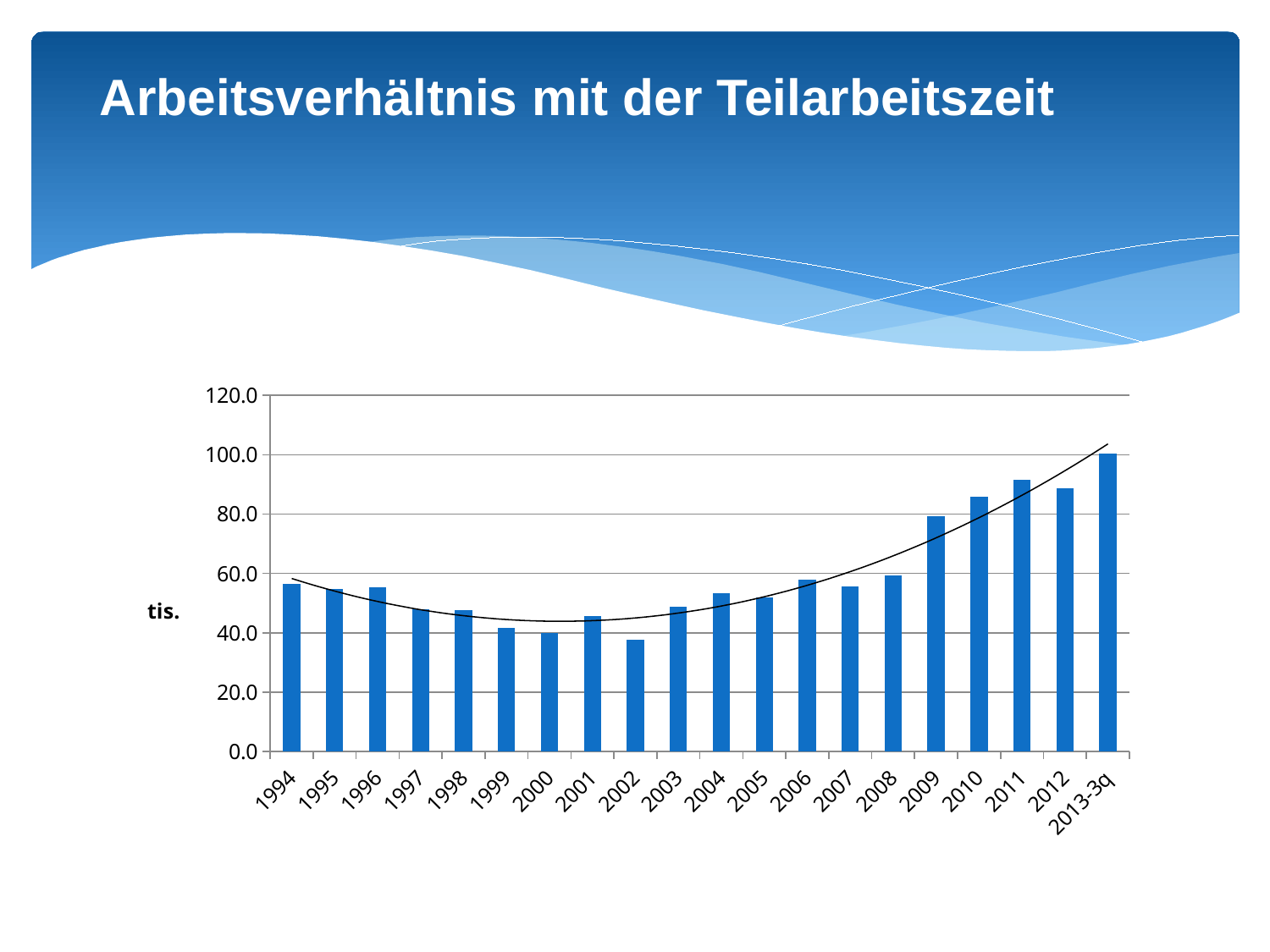
Is the value for 1994 greater or less than 60? less Do the values generally rise or fall from 2002 to 2013-3q? rise Which is larger, the value for 2011 or the value for 2012? 2011 Which is larger, the value for 1994 or the value for 2000? 1994 How many categories (years) are shown on the x axis of the chart? 20 Is the value for 2011 greater or less than 80? greater Which year has the highest bar in the chart? 2013-3q Is the value for 2012 greater or less than 80? greater What kind of chart is shown on the slide? bar chart What label is shown on the vertical axis of the chart? tis.